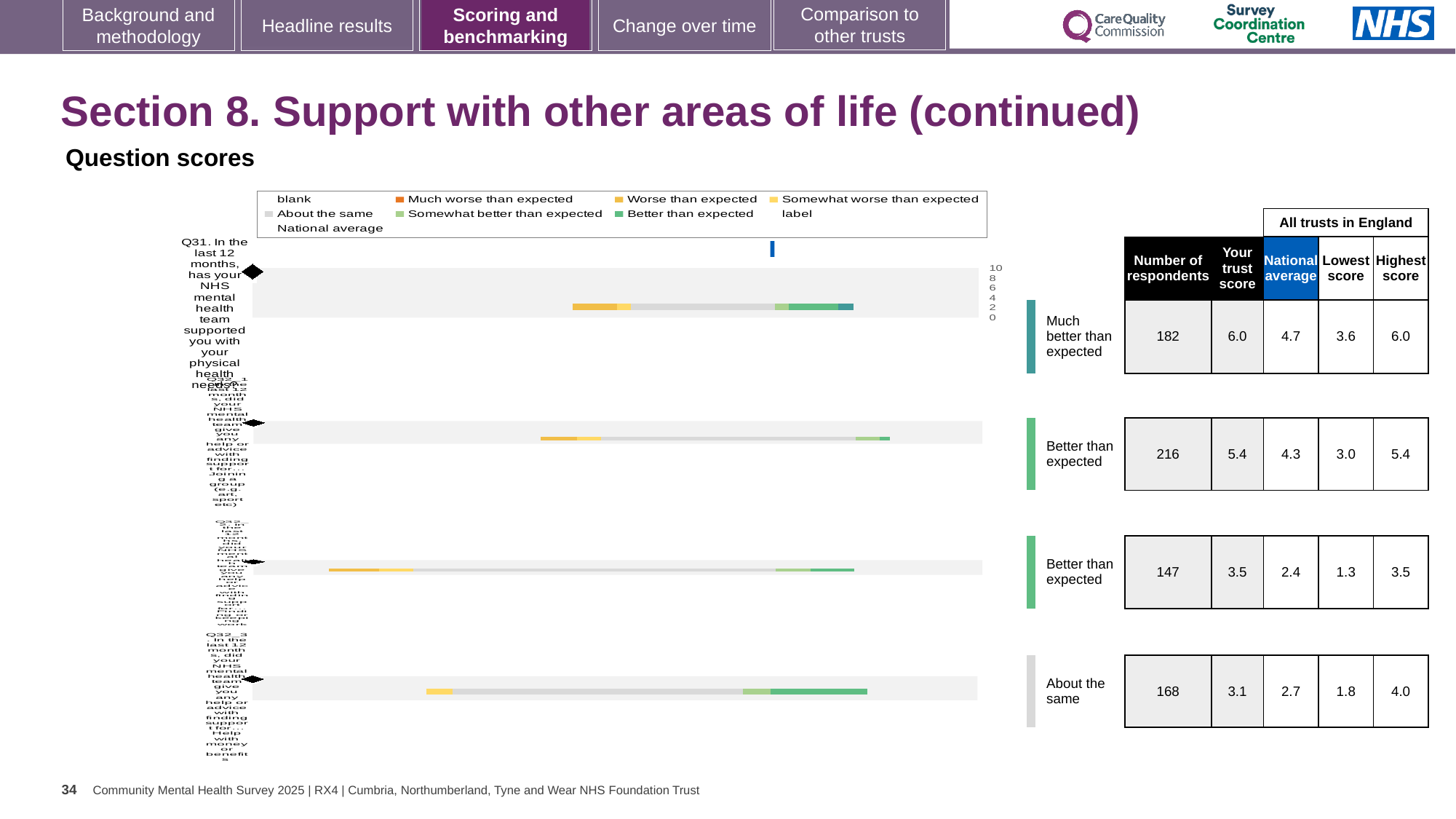
What benchmark category is shown for the fourth (bottom) question row? About the same How many question bars are plotted in the question scores chart? 4 Which question row has the lowest 'Your trust score'? the fourth row (3.1) What is the national average score for Q31? 4.7 What type of chart is used to show the question scores on this slide? bar chart What is the highest score across all trusts in England for the fourth (bottom) question row? 4.0 What is the 'Your trust score' value for Q31 (support with physical health needs)? 6.0 How many respondents are listed for Q31 in the table next to the chart? 182 Which row of the table has the highest number of respondents? the second row (216) What is the difference between the trust score and the national average for Q31? 1.3 What colour does the legend use for 'Better than expected'? green For the third question row, which is larger: the trust score or the national average? the trust score (3.5)